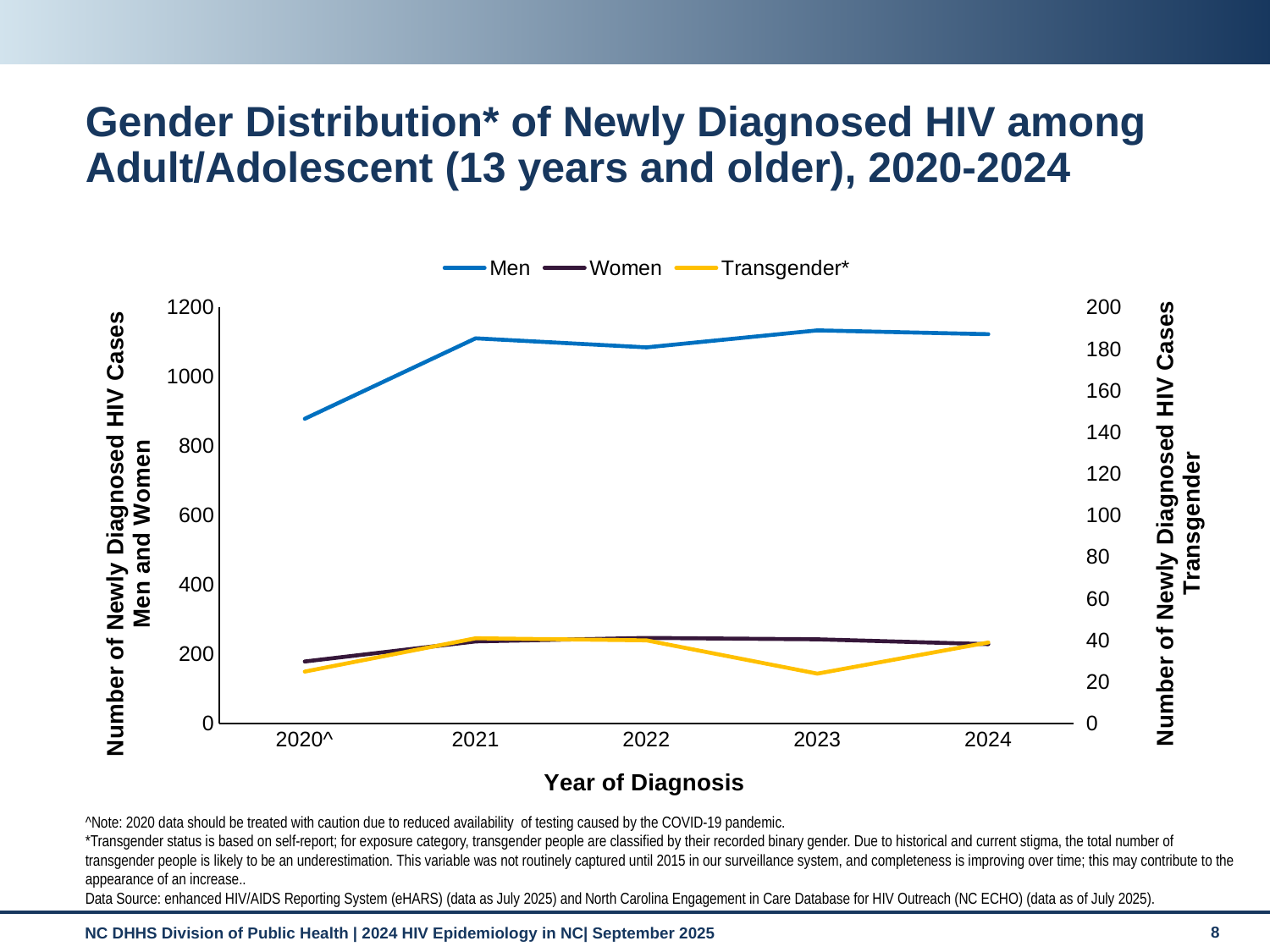
What kind of chart is shown on the slide? Line chart How many series does the legend list? 3 Is the value for Women in 2020^ greater or less than 200? less In which year is the value for Men lowest? 2020^ Does the value for Men rise or fall from 2020^ to 2021? rise Which series has the lowest value in 2020^? Transgender* In which year is the value for Women lowest? 2020^ What is the title of the x axis? Year of Diagnosis Is the value for Transgender* in 2023 greater or less than 40 on the right axis? less Is the value for Men in 2020^ greater or less than 1000? less How many years of diagnosis are plotted along the x axis? 5